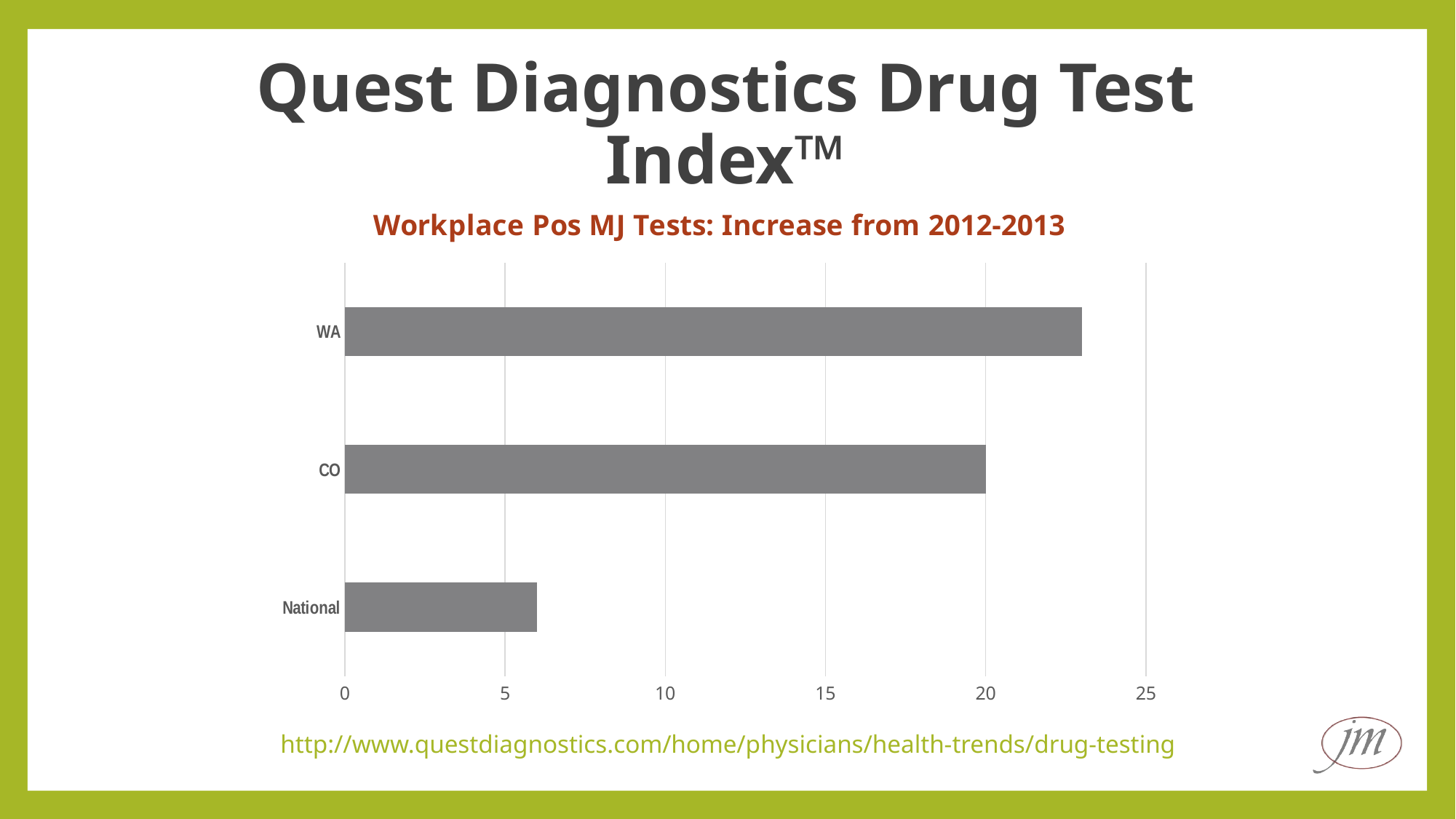
Which category has the lowest value in the chart? National Is the value for WA greater or less than 20? greater Is the value for WA greater or less than 25? less Which category has the highest value in the chart? WA What is the title of the chart? Workplace Pos MJ Tests: Increase from 2012-2013 What kind of chart is shown on the slide? bar chart Is the value for National greater or less than 5? greater What is the highest value shown on the horizontal axis? 25 How many categories are plotted in the chart? 3 Which is larger, the value for WA or the value for CO? WA What is the value for CO? 20